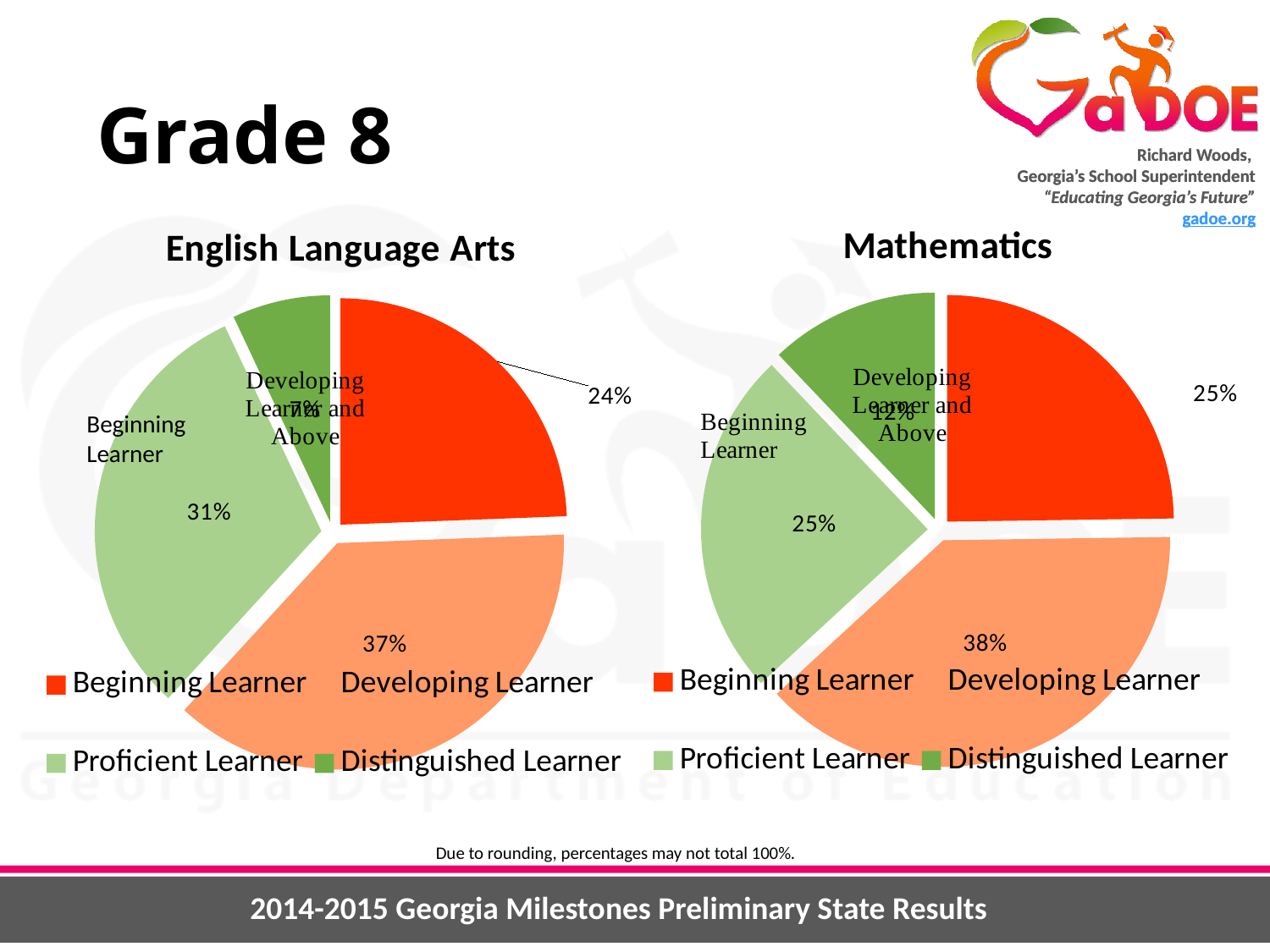
What type of chart is used for the English Language Arts results? Pie chart In the Mathematics pie chart, what percentage is shown for Beginning Learner? 25% In the English Language Arts pie chart, what percentage is shown for Beginning Learner? 24% In the Mathematics pie chart, which is larger, Developing Learner or Beginning Learner? Developing Learner In the English Language Arts pie chart, which category has the largest slice? Developing Learner In the English Language Arts pie chart, what percentage is shown for Proficient Learner? 31% How many categories does the legend of the Mathematics chart list? 4 In the Mathematics pie chart, what percentage is shown for Developing Learner? 38% In the English Language Arts pie chart, how many percentage points larger is Developing Learner than Proficient Learner? 6 percentage points In the Mathematics pie chart, which category has the smallest slice? Distinguished Learner In the Mathematics pie chart, what percentage is shown for Proficient Learner? 25% In the English Language Arts pie chart, what percentage is shown for Developing Learner? 37%